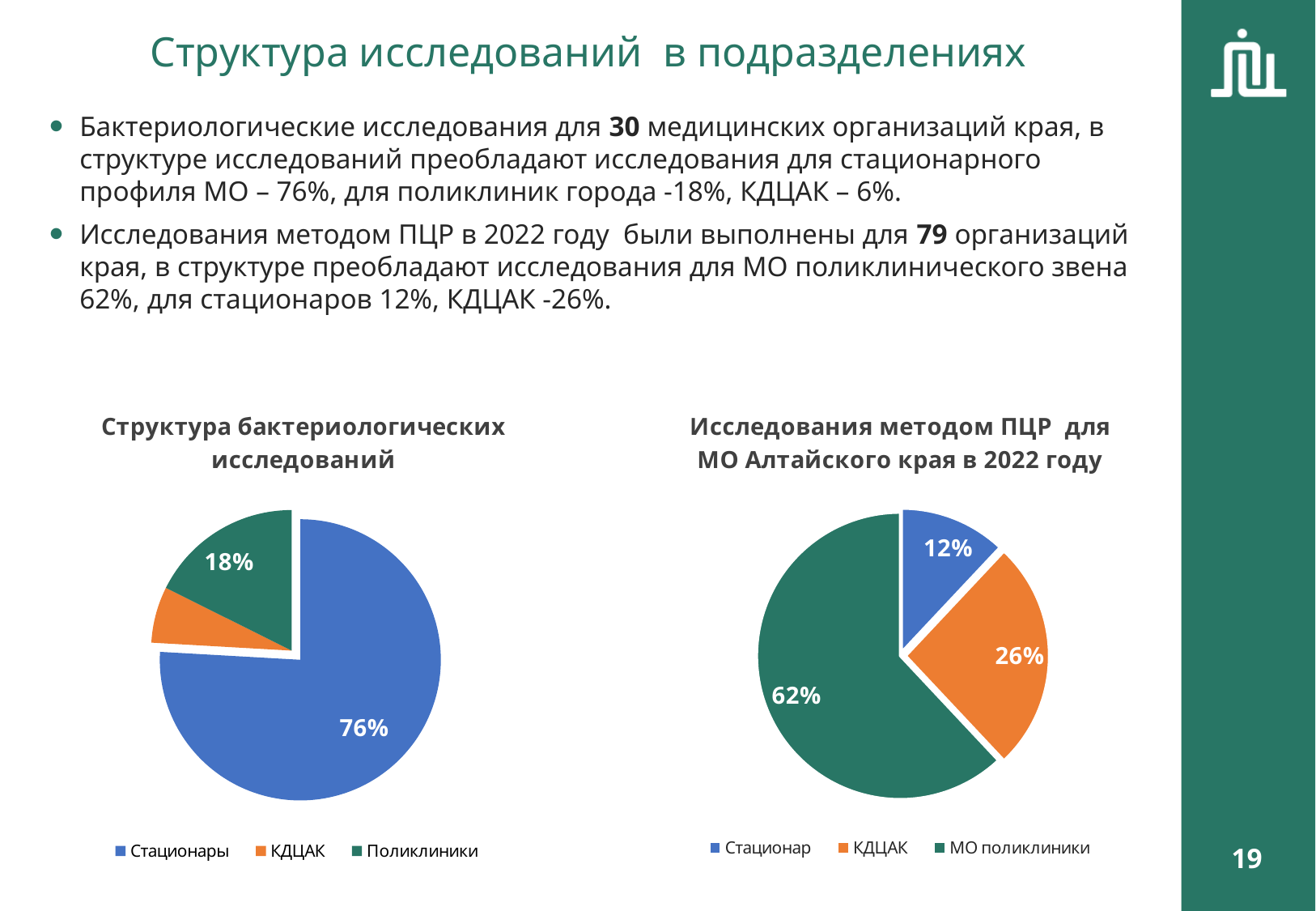
In the chart titled "Исследования методом ПЦР для МО Алтайского края в 2022 году", which category has the smallest slice? Стационар In the chart titled "Структура бактериологических исследований", what share of the pie is Стационары? 76% In the chart titled "Структура бактериологических исследований", which category has the largest slice? Стационары What type of chart is the chart on the right of the slide? Pie chart In the chart titled "Структура бактериологических исследований", what is the difference between the Стационары and Поликлиники shares? 58% In the chart titled "Исследования методом ПЦР для МО Алтайского края в 2022 году", what share of the pie is КДЦАК? 26% In the chart titled "Исследования методом ПЦР для МО Алтайского края в 2022 году", what share of the pie is Стационар? 12% In the chart titled "Структура бактериологических исследований", which category has the smallest slice? КДЦАК In the chart titled "Исследования методом ПЦР для МО Алтайского края в 2022 году", what is the difference between the МО поликлиники and КДЦАК shares? 36% How many categories does the legend of the chart titled "Структура бактериологических исследований" list? 3